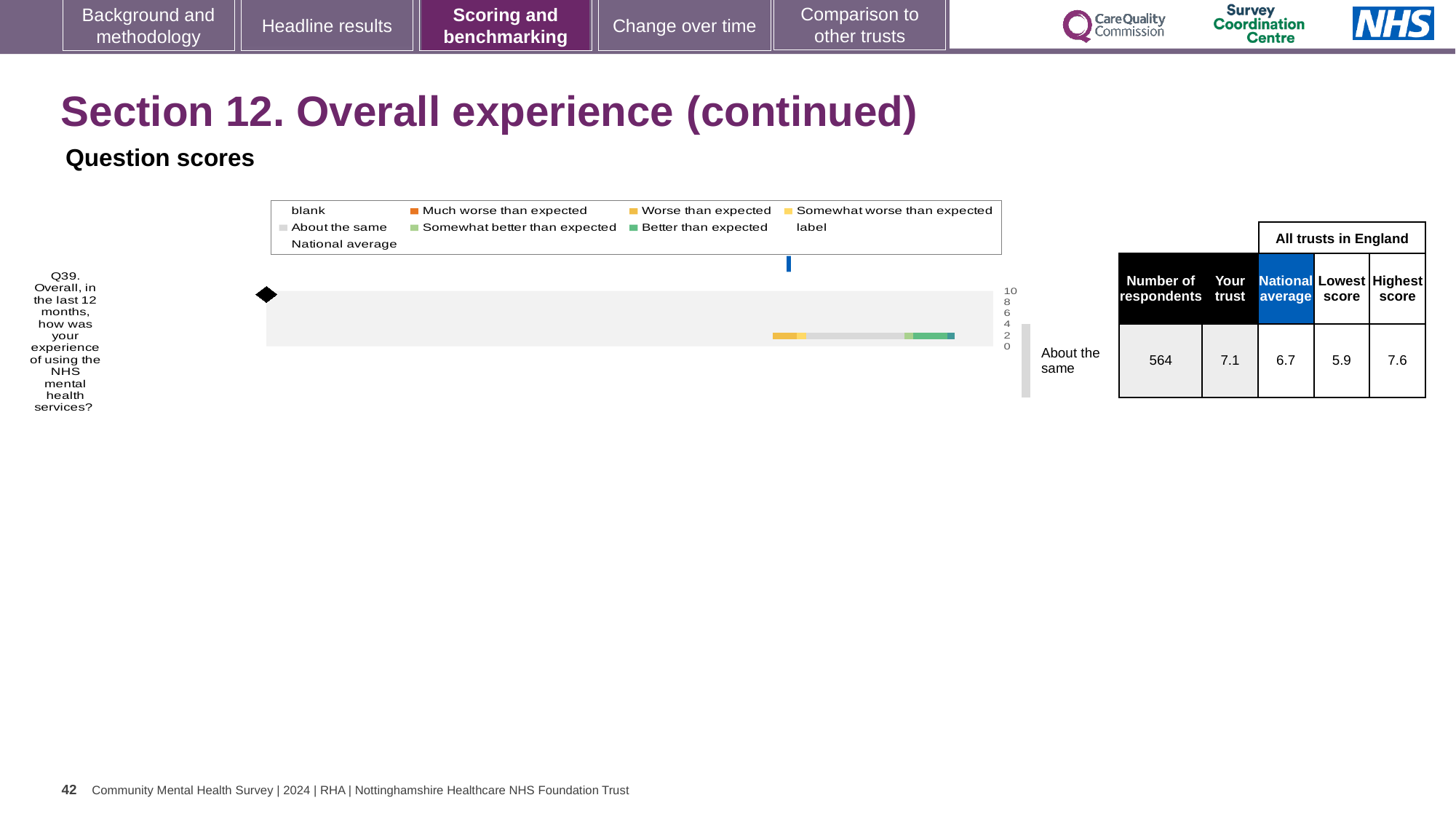
Which benchmarking category is the trust's score for Q39 labelled as in the chart? About the same What is the 'Your trust' score for Q39 shown in the table beside the chart? 7.1 For Q39, what is the difference between the highest score and the lowest score among all trusts in England? 1.7 What is the highest value shown on the chart's numeric axis? 10 For Q39, how much higher is the 'Your trust' score than the national average? 0.4 How many respondents answered Q39 according to the table beside the chart? 564 What is the highest score among all trusts in England for Q39? 7.6 What is the lowest score among all trusts in England for Q39? 5.9 What is the national average score for Q39 shown in the table beside the chart? 6.7 What kind of chart is shown on the slide for Q39? bar chart How many survey questions are plotted in the chart on this slide? 1 For Q39, which is larger: the 'Your trust' score or the national average? Your trust